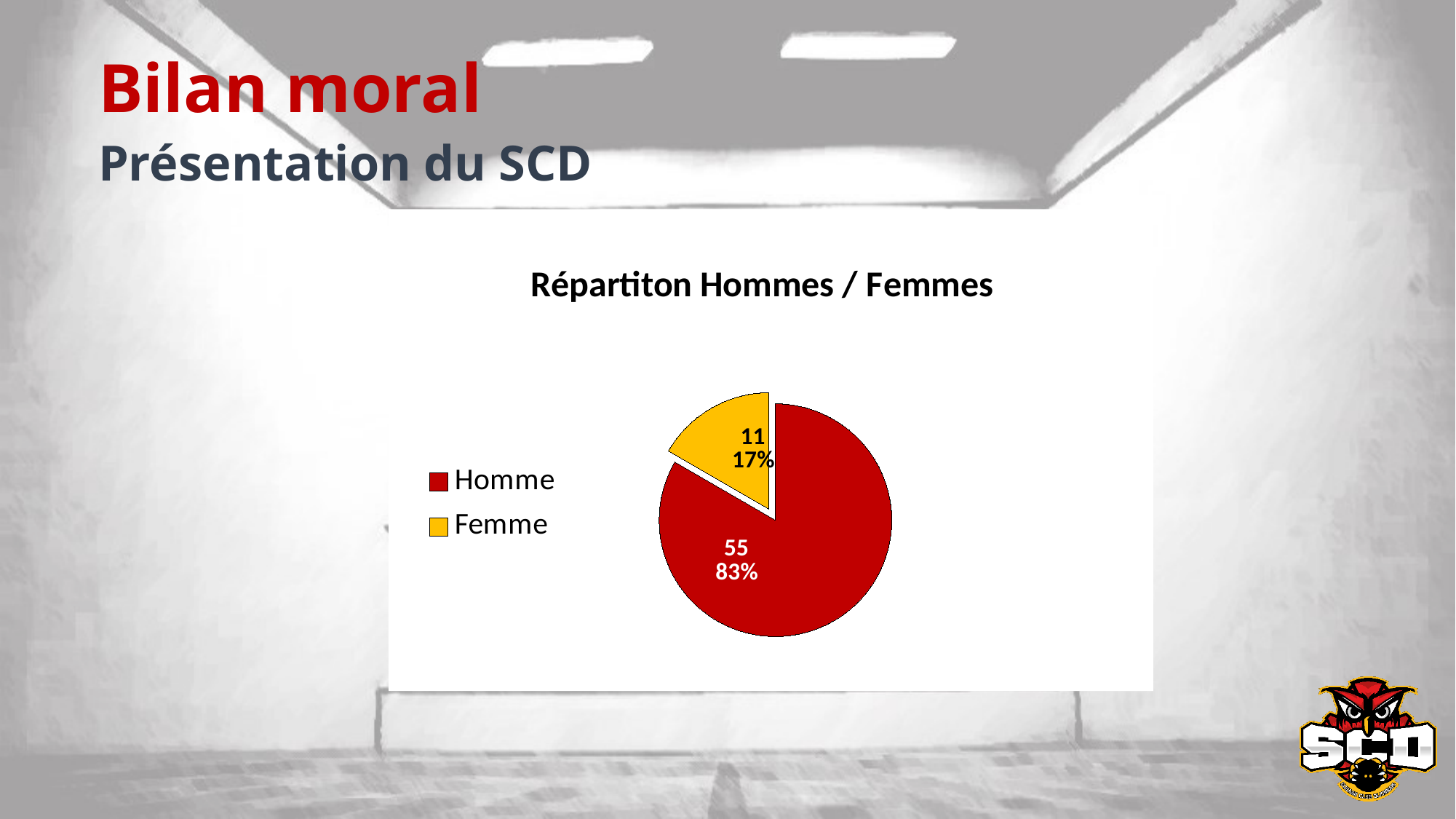
What is the value for Homme? 55 How many categories does the pie chart have? 2 What share of the pie does Homme represent? 83% What is the title of the chart? Répartiton Hommes / Femmes What share of the pie does Femme represent? 17% What is the difference between the values for Homme and Femme? 44 Which category has the smallest slice? Femme Which category has the largest slice? Homme Which is larger, the value for Homme or the value for Femme? Homme What colour is the Femme slice? yellow What is the value for Femme? 11 What type of chart is shown on the slide? pie chart